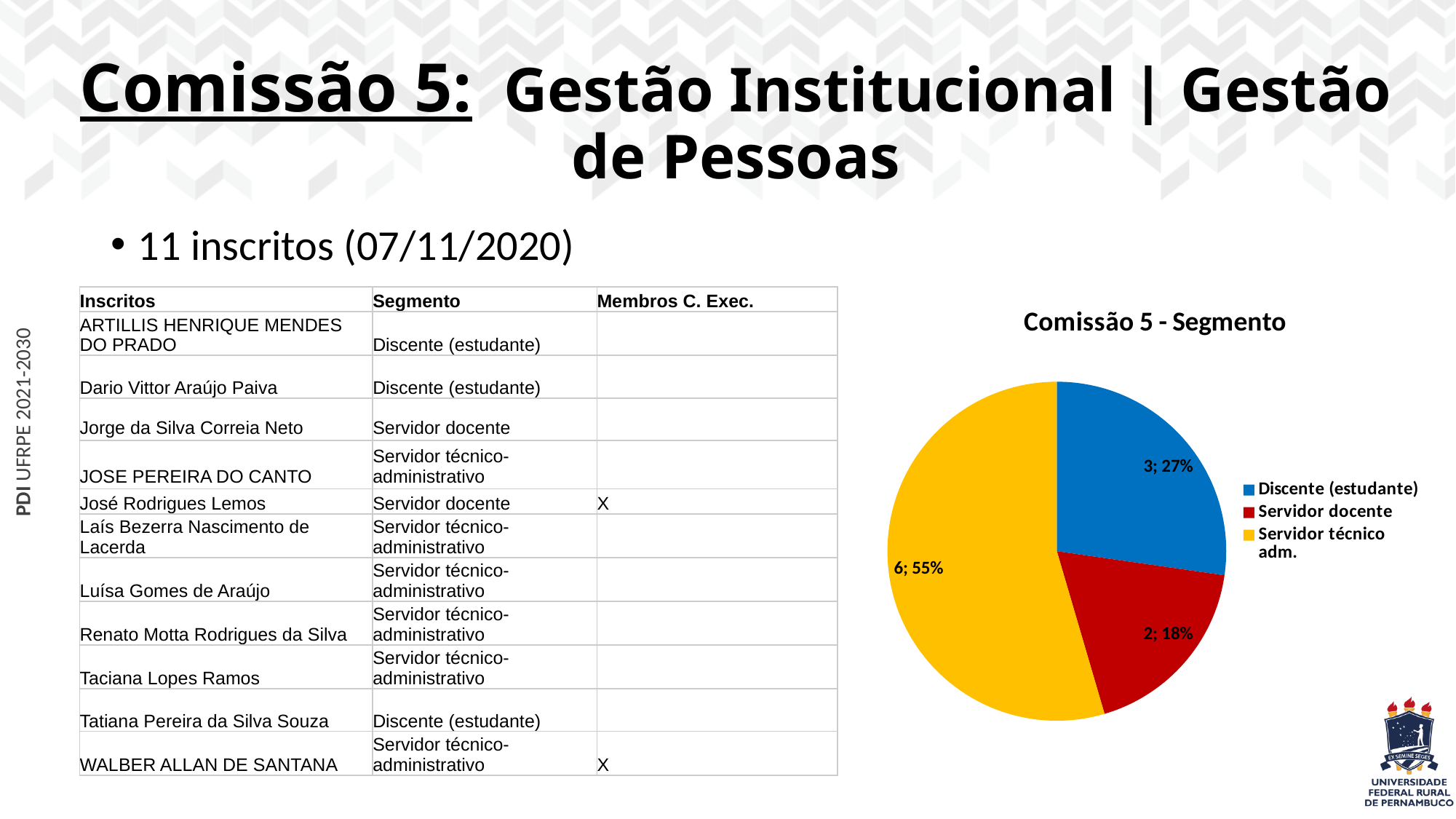
Which segment has the smallest slice in the pie chart? Servidor docente How many entries does the chart legend list? 3 How many members are in the Discente (estudante) segment according to the chart? 3 What kind of chart is shown on the slide? pie chart Which is larger, the Discente (estudante) slice or the Servidor docente slice? Discente (estudante) Which segment has the largest slice in the pie chart? Servidor técnico adm. How many slices does the pie chart have? 3 What colour is the Servidor técnico adm. slice? yellow What percentage share does the Servidor docente slice have? 18% What percentage share does the Servidor técnico adm. slice have? 55% What is the title of the chart? Comissão 5 - Segmento What is the difference in count between the Servidor técnico adm. and Discente (estudante) slices? 3